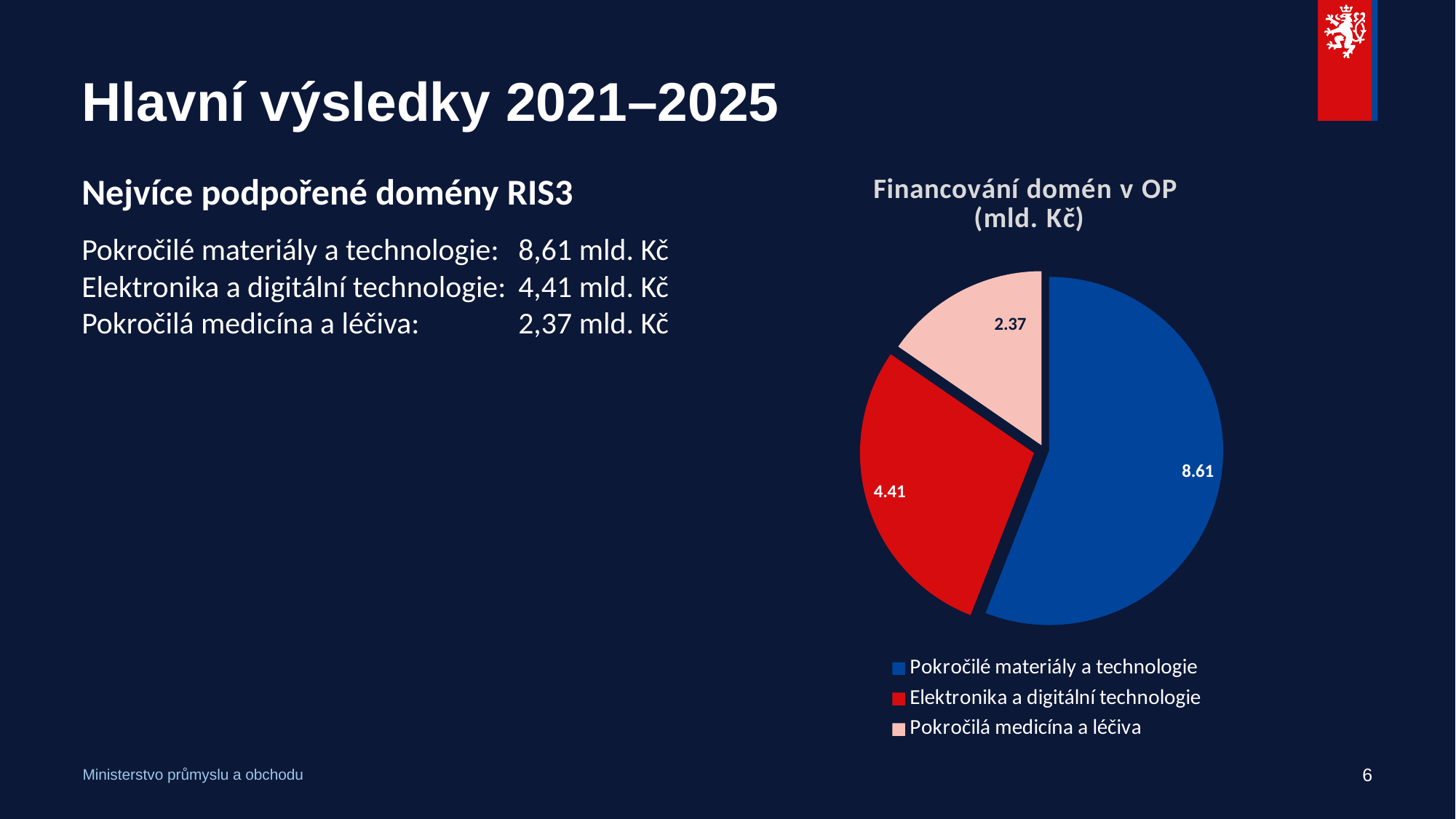
What is the value for Pokročilé materiály a technologie in the pie chart? 8.61 What kind of chart is shown on the slide? Pie chart What is the title of the chart? Financování domén v OP (mld. Kč) What is the difference between the values for Elektronika a digitální technologie and Pokročilá medicína a léčiva? 2.04 How many slices does the pie chart have? 3 What is the total of all values shown in the pie chart? 15.39 What is the value for Elektronika a digitální technologie in the pie chart? 4.41 Which domain has the largest slice in the pie chart? Pokročilé materiály a technologie What is the value for Pokročilá medicína a léčiva in the pie chart? 2.37 Which is larger: the value for Elektronika a digitální technologie or Pokročilá medicína a léčiva? Elektronika a digitální technologie Which domain has the smallest slice in the pie chart? Pokročilá medicína a léčiva What is the difference between the values for Pokročilé materiály a technologie and Elektronika a digitální technologie? 4.20